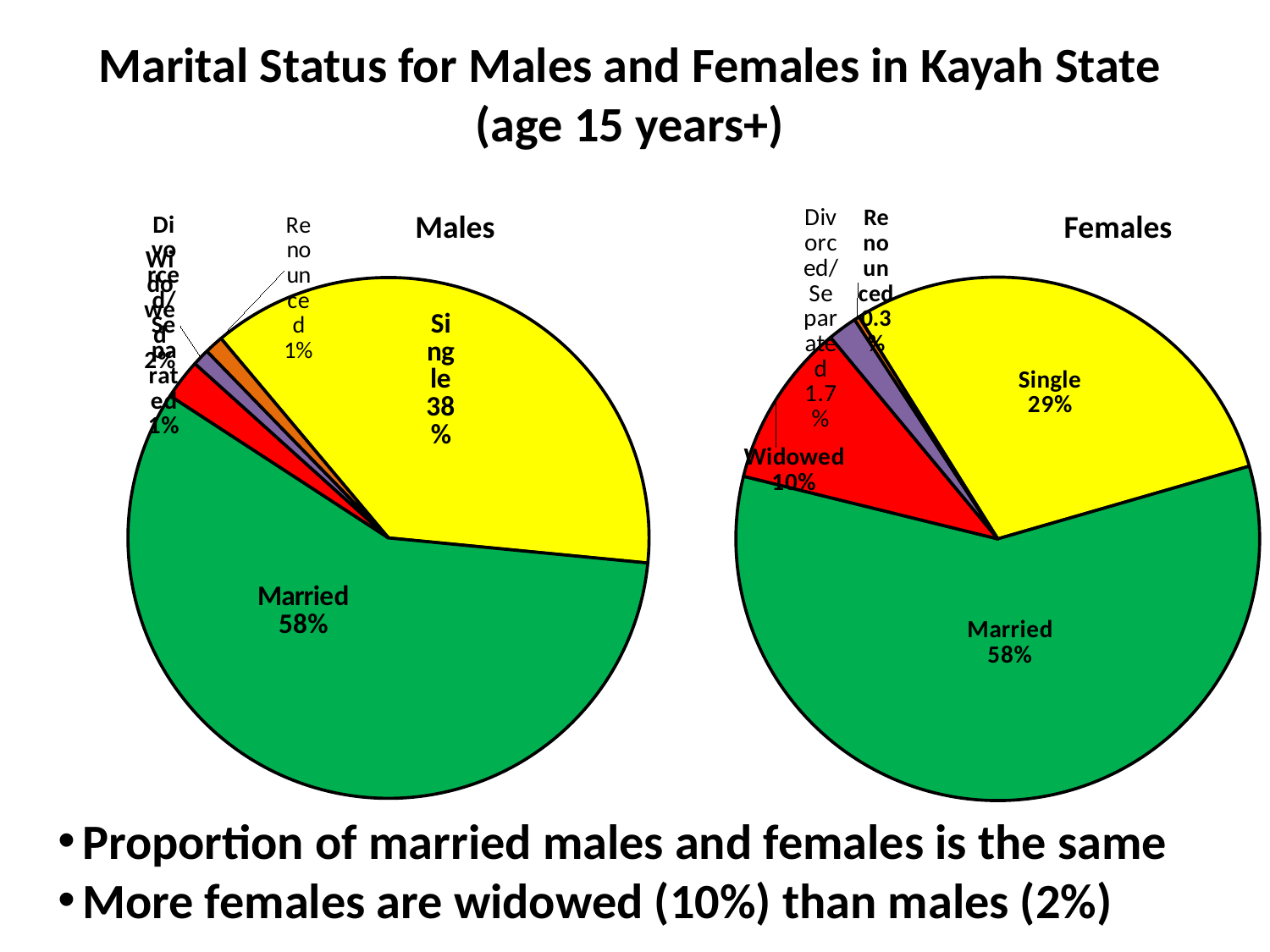
Which is larger: the widowed share in the Females chart or the widowed share in the Males chart? Females In the Females pie chart, what percentage of females are renounced? 0.3% What is the difference between the single share in the Males chart and the single share in the Females chart? 9 percentage points In the Males pie chart, which marital status has the largest share? Married In the Females pie chart, which marital status has the largest share? Married In the Males pie chart, what percentage of males are single? 38% In the Females pie chart, what percentage of females are divorced/separated? 1.7% What type of chart is used to show marital status for males and females? Pie chart In the Females pie chart, what percentage of females are single? 29% In the Females pie chart, what percentage of females are widowed? 10% In the Females pie chart, which marital status has the smallest share? Renounced In the Males pie chart, what percentage of males are married? 58%